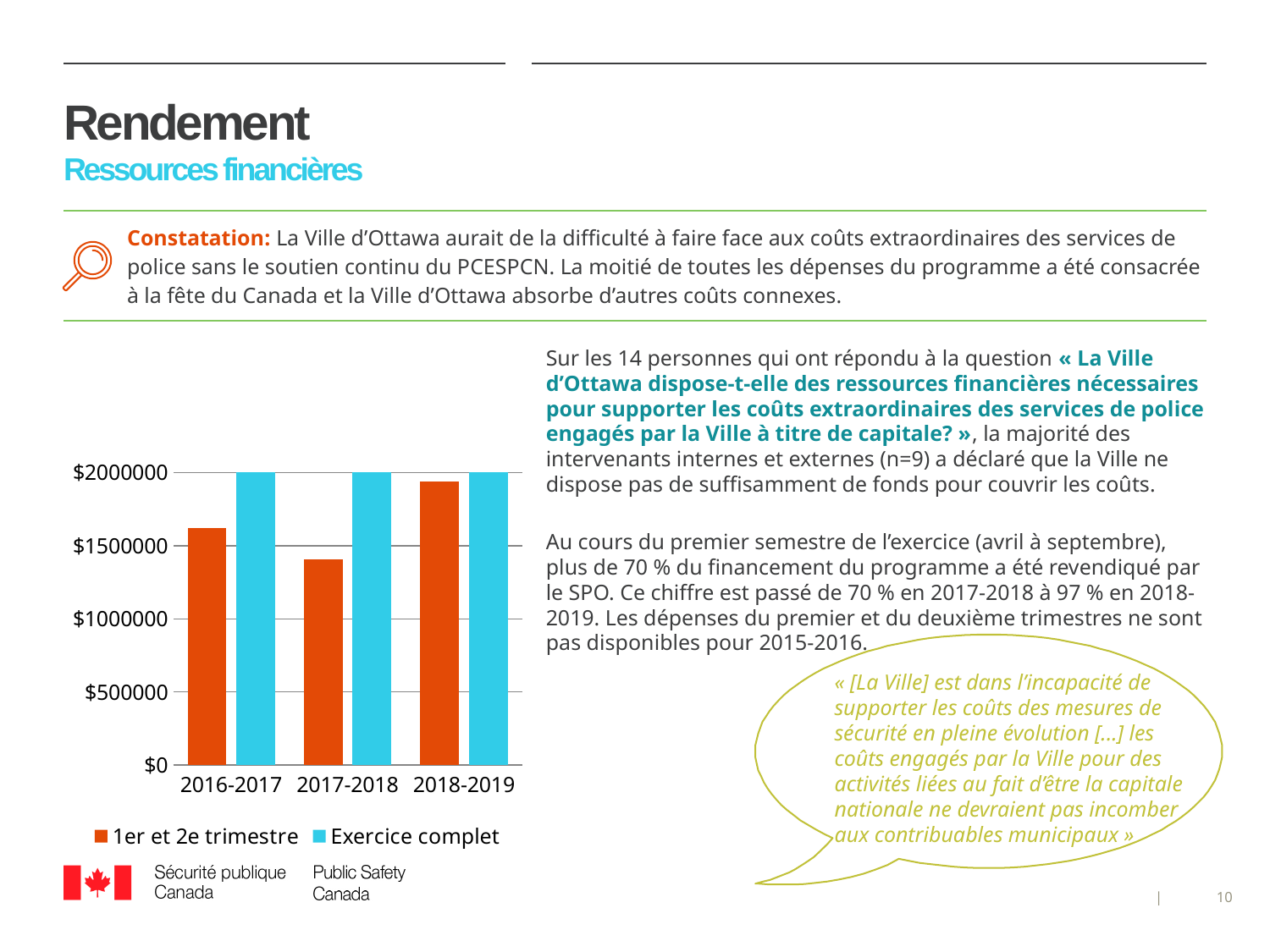
Which is larger: the '1er et 2e trimestre' value for 2016-2017 or for 2017-2018? 2016-2017 Which fiscal year has the highest value for '1er et 2e trimestre'? 2018-2019 How many fiscal years (categories) are shown on the x axis of the chart? 3 Is the '1er et 2e trimestre' value for 2016-2017 greater or less than $1500000? greater Which fiscal year has the lowest value for '1er et 2e trimestre'? 2017-2018 Which colour represents the 'Exercice complet' series in the chart? blue Is the '1er et 2e trimestre' value for 2018-2019 greater or less than $1500000? greater How many series does the chart's legend list? 2 What are the two series named in the chart's legend? 1er et 2e trimestre; Exercice complet Is the '1er et 2e trimestre' value for 2017-2018 greater or less than $1500000? less What kind of chart is shown on the slide? bar chart Does the '1er et 2e trimestre' value rise or fall from 2017-2018 to 2018-2019? rise